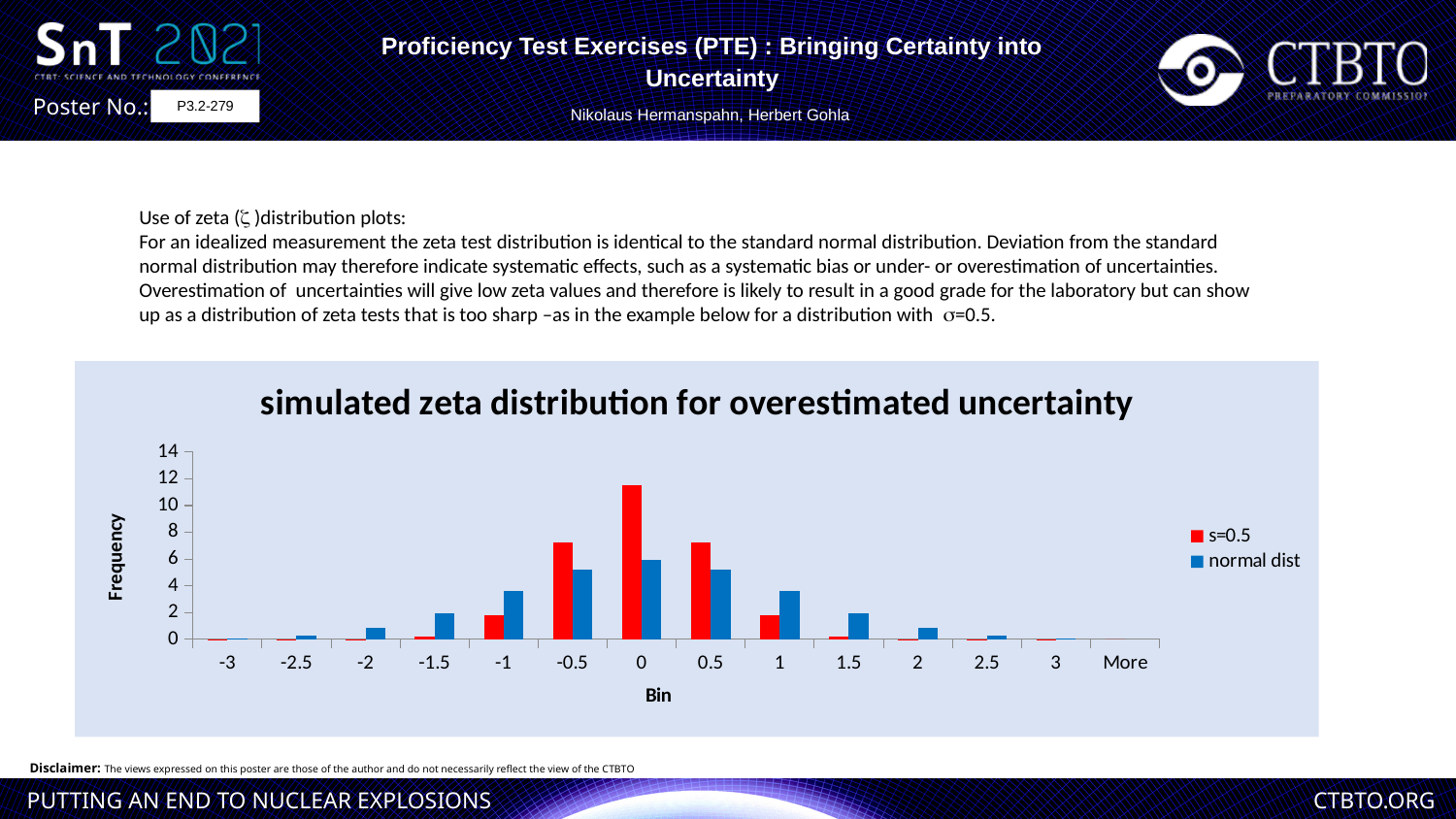
Is the frequency for the normal dist series at bin 0 greater or less than 8? less At bin -1, which series has the larger frequency, s=0.5 or normal dist? normal dist What is the title of the chart? simulated zeta distribution for overestimated uncertainty Is the frequency for the s=0.5 series at bin 0 greater or less than 10? greater How many bins are shown along the x axis of the chart? 14 Which bin has the highest frequency for the normal dist series? 0 Is the frequency for the s=0.5 series at bin -0.5 greater or less than 6? greater Do the frequencies for the normal dist series rise or fall from bin 0 to bin 3? fall Which bin has the highest frequency for the s=0.5 series? 0 How many series does the chart's legend list? 2 What kind of chart is shown on the slide? bar chart At bin 0, which series has the larger frequency, s=0.5 or normal dist? s=0.5